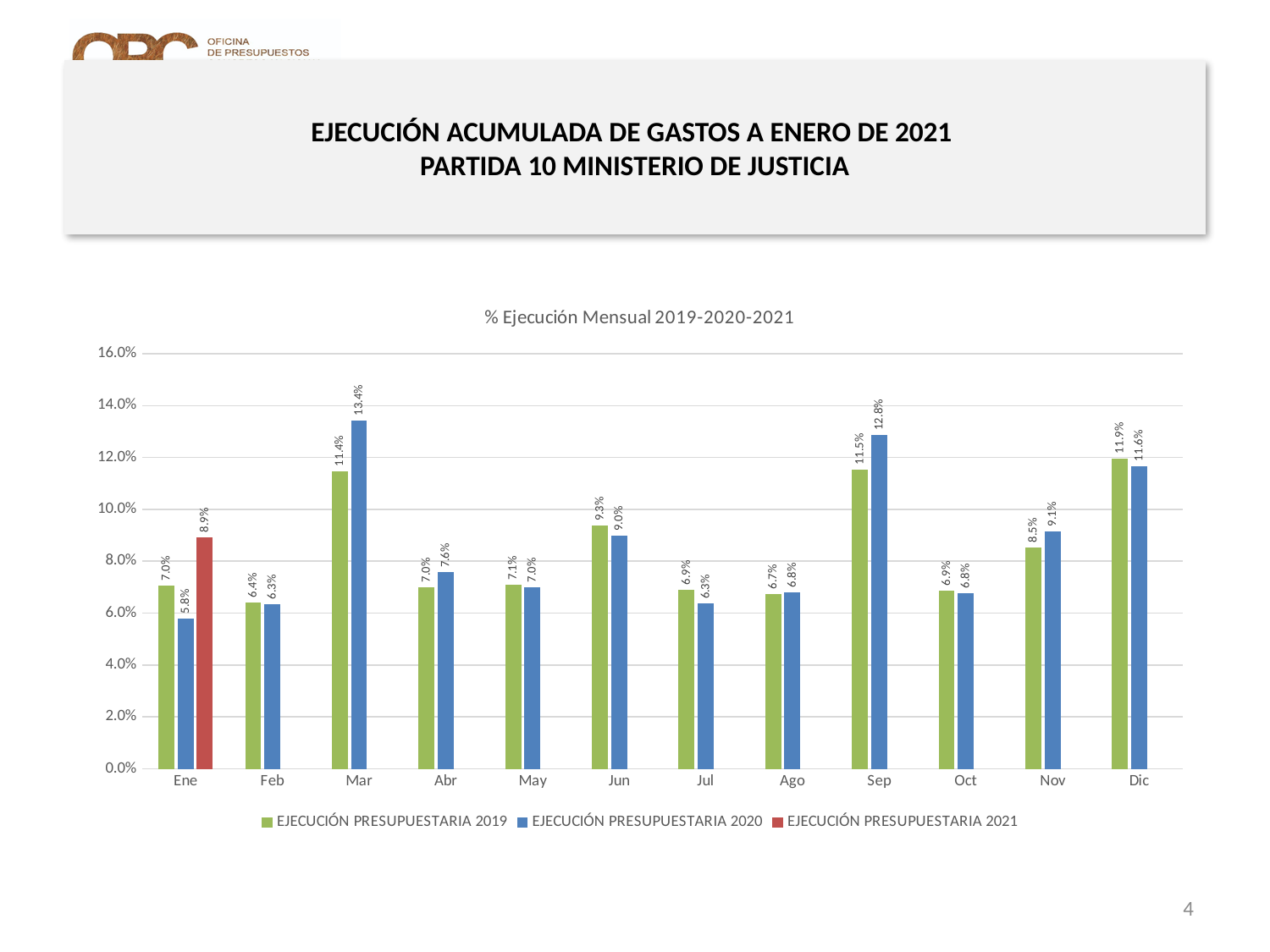
What is the value for EJECUCIÓN PRESUPUESTARIA 2021 in Ene? 8.9% What kind of chart is shown on the slide? Bar chart What is the value for EJECUCIÓN PRESUPUESTARIA 2020 in Mar? 13.4% In which month is the EJECUCIÓN PRESUPUESTARIA 2020 value highest? Mar What is the title of the chart? % Ejecución Mensual 2019-2020-2021 What is the value for EJECUCIÓN PRESUPUESTARIA 2019 in Sep? 11.5% In which month is the EJECUCIÓN PRESUPUESTARIA 2020 value lowest? Ene How many series does the legend list? 3 How many months are shown on the x axis of the chart? 12 What is the difference between the EJECUCIÓN PRESUPUESTARIA 2020 and EJECUCIÓN PRESUPUESTARIA 2019 values in Mar? 2.0% Which is larger in Nov: the EJECUCIÓN PRESUPUESTARIA 2019 value or the EJECUCIÓN PRESUPUESTARIA 2020 value? EJECUCIÓN PRESUPUESTARIA 2020 Is the EJECUCIÓN PRESUPUESTARIA 2019 value for Dic greater or less than 10.0%? greater